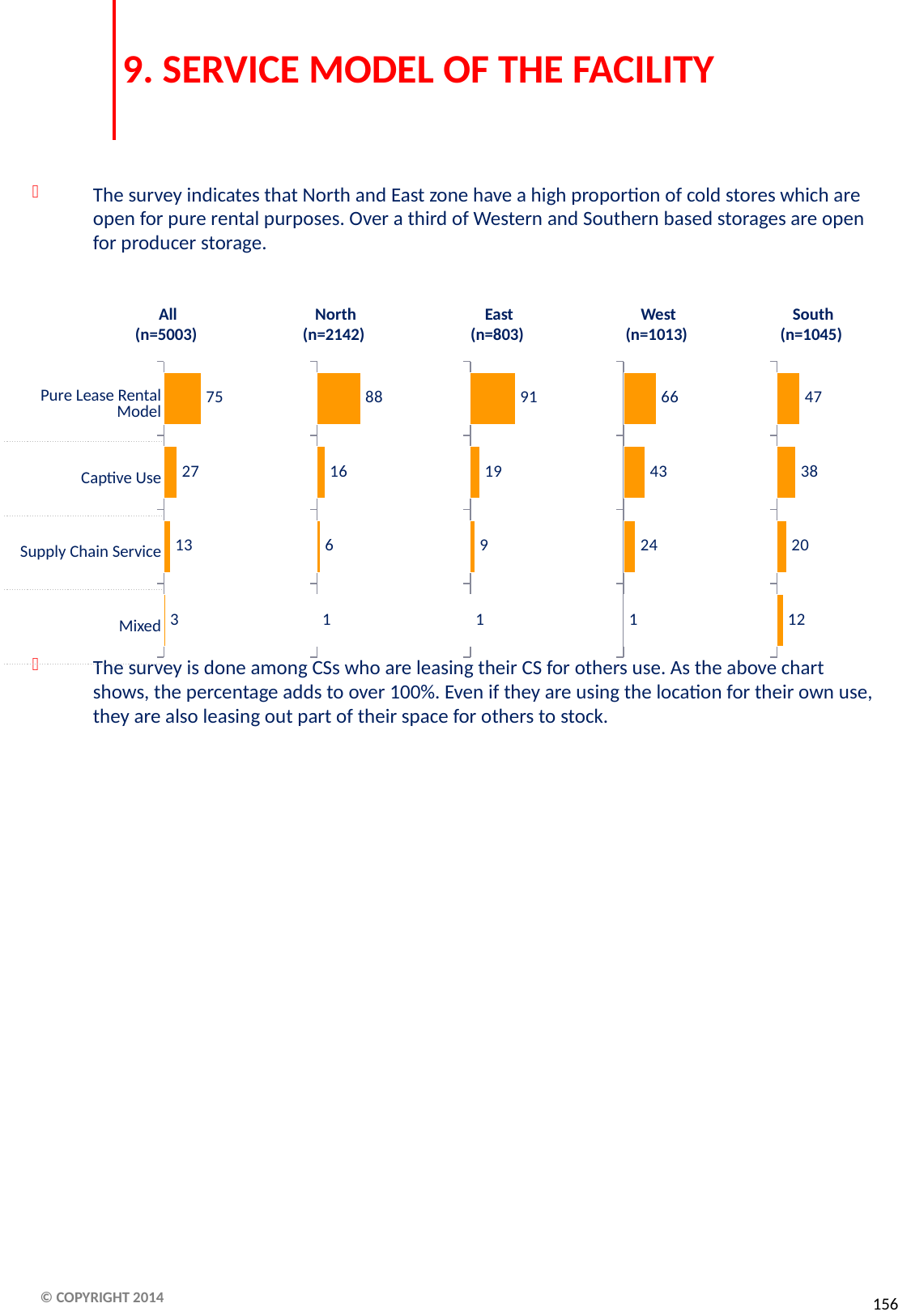
In the West (n=1013) chart, what is the difference between Pure Lease Rental Model and Captive Use? 23 In the West (n=1013) chart, which category has the highest value? Pure Lease Rental Model Which is larger: Captive Use in the West (n=1013) chart or Captive Use in the South (n=1045) chart? West (n=1013) In the East (n=803) chart, what is the difference between Pure Lease Rental Model and Captive Use? 72 In the South (n=1045) chart, what is the value for Mixed? 12 In the East (n=803) chart, what is the value for Supply Chain Service? 9 What type of chart is used for the North (n=2142) data? Bar chart In the North (n=2142) chart, what is the value for Captive Use? 16 How many categories are shown in each of the bar charts on the slide? 4 In the South (n=1045) chart, which category has the lowest value? Mixed How many separate bar charts are shown on the slide? 5 In the All (n=5003) chart, what is the value for Pure Lease Rental Model? 75